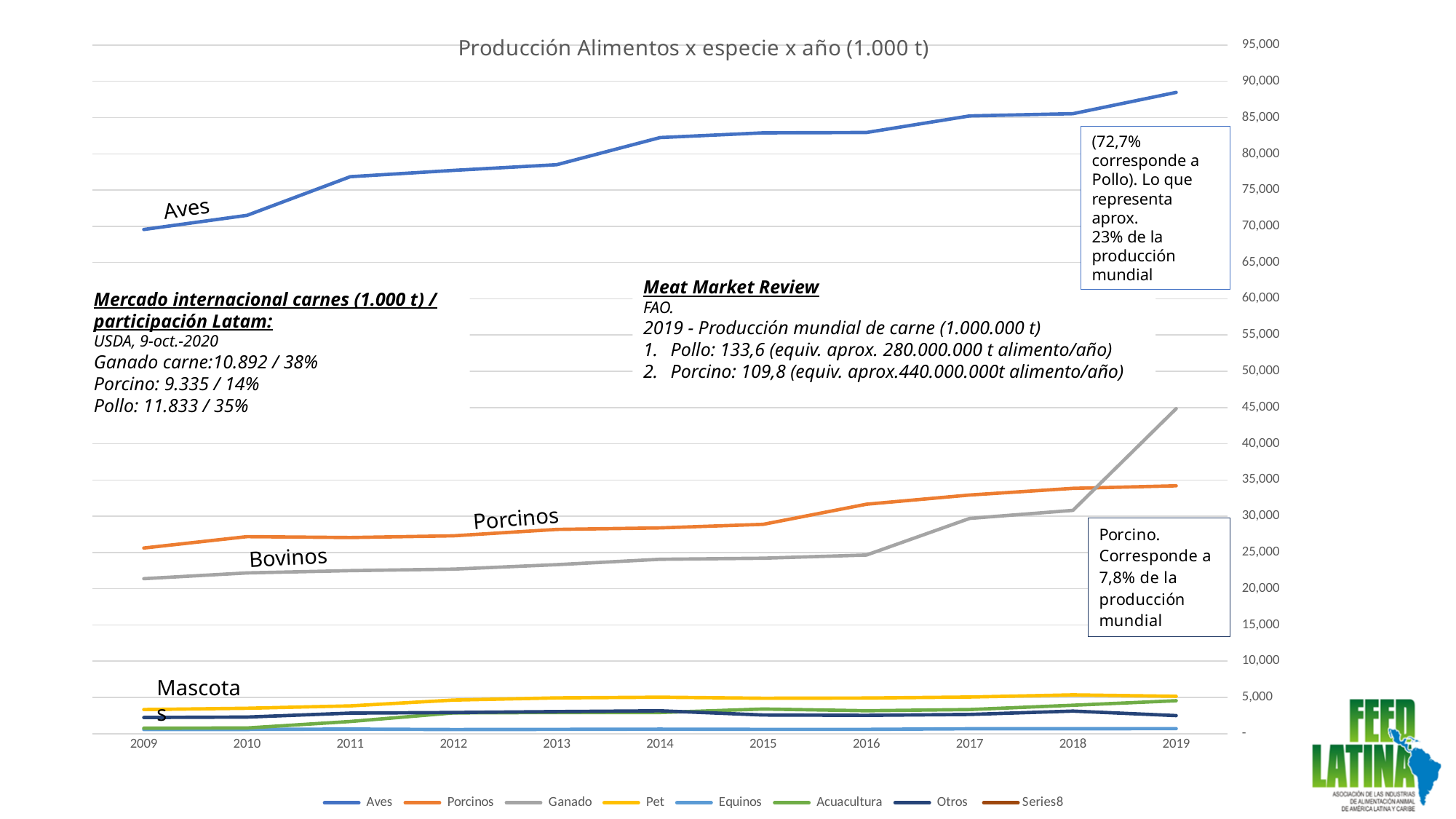
How many years are plotted along the x axis? 11 Is the value for Ganado in 2009 greater or less than 25,000? less Does the Aves series rise or fall from 2009 to 2019? rise What is the title of the chart? Producción Alimentos x especie x año (1.000 t) Which series has the highest value in 2019? Aves Is the value for Aves in 2009 greater or less than 65,000? greater Which series has the lowest value in 2019? Equinos Is the value for Aves in 2019 greater or less than 85,000? greater What kind of chart is shown on the slide? line chart In 2009, which is larger: Porcinos or Ganado? Porcinos How many series does the chart legend list? 8